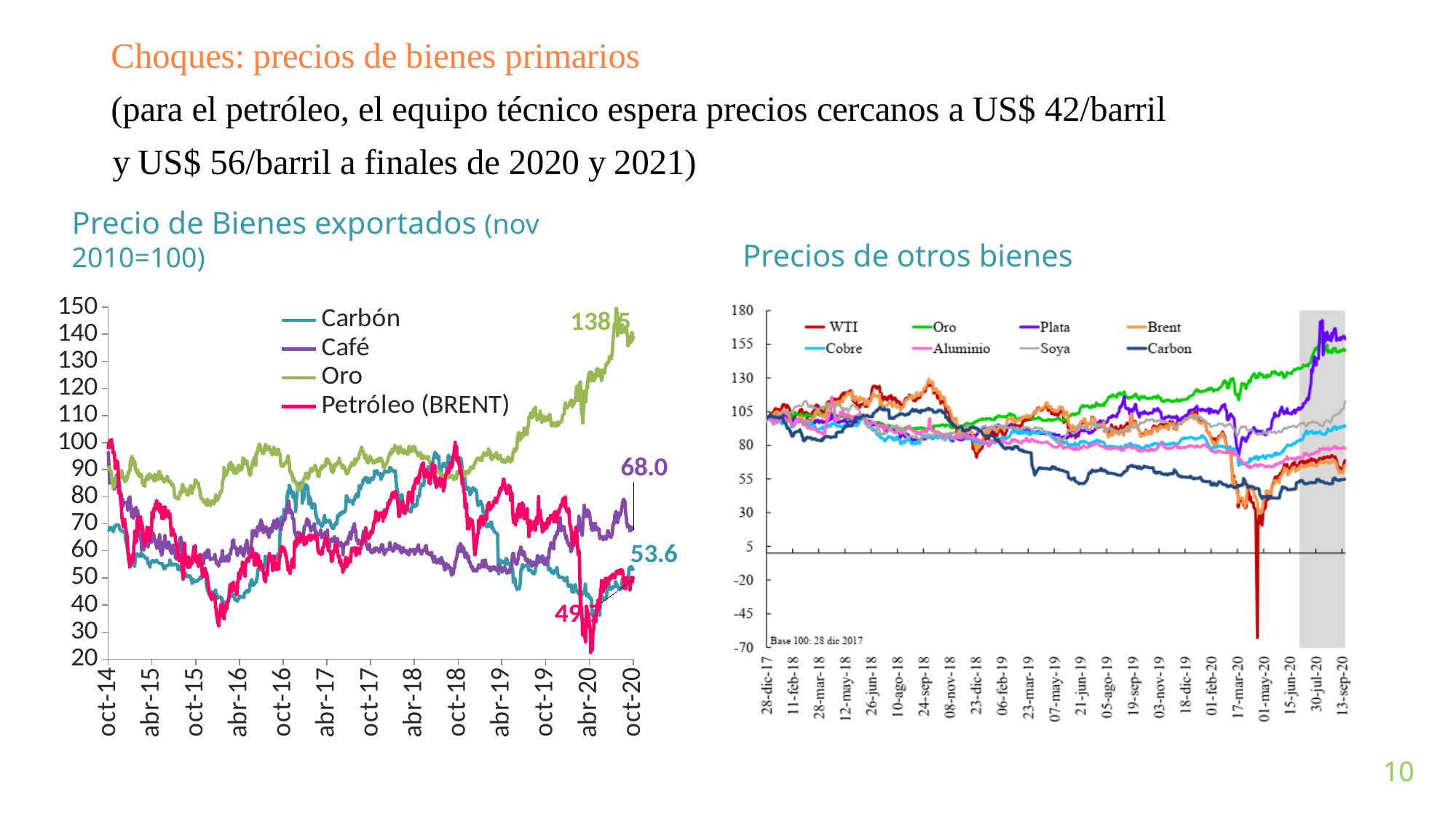
In the 'Precio de Bienes exportados' chart, does the Oro series rise or fall between abr-19 and oct-20? rise In the 'Precio de Bienes exportados' chart, which series has the highest value at oct-20? Oro What kind of chart is the 'Precio de Bienes exportados' chart on the left? line chart In the 'Precio de Bienes exportados' chart, what is the labelled final value for Oro? 138.5 In the 'Precio de Bienes exportados' chart, what is the labelled final value for Carbón? 53.6 How many series does the legend of the 'Precios de otros bienes' chart list? 8 In the 'Precio de Bienes exportados' chart, which has the larger labelled final value, Café or Carbón? Café In the 'Precio de Bienes exportados' chart, is the lowest value of Petróleo (BRENT) around abr-20 greater or less than 30? less In the 'Precios de otros bienes' chart, which series drops below -45 around 01-may-20? WTI In the 'Precio de Bienes exportados' chart, what is the difference between the labelled final values of Oro and Café? 70.5 In the 'Precio de Bienes exportados' chart, what is the labelled final value for Café? 68.0 How many series does the legend of the 'Precio de Bienes exportados' chart list? 4